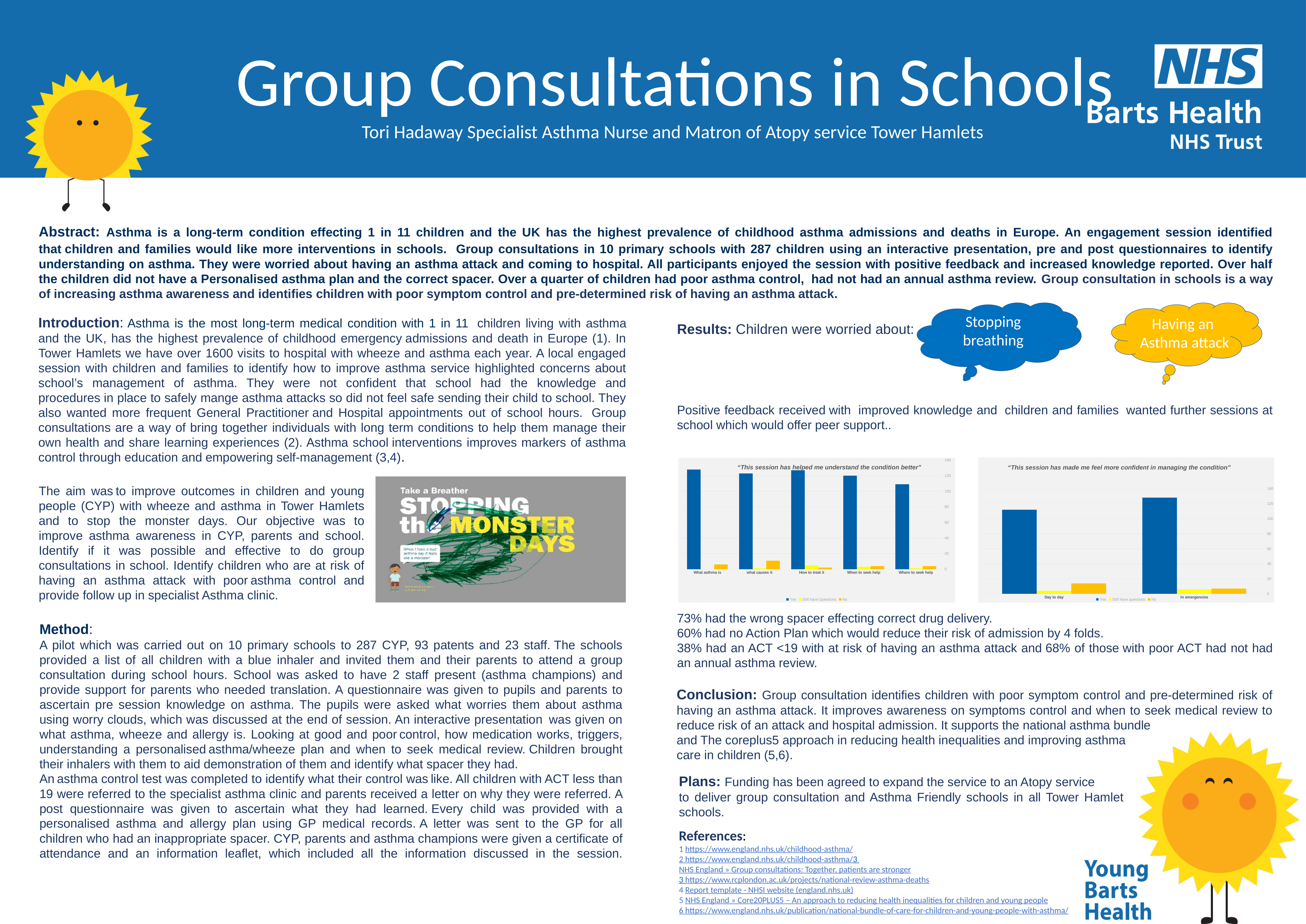
In the chart "This session has helped me understand the condition better", is the Yes value for "What asthma is" greater or less than 100? greater How many categories are shown on the x axis of the chart "This session has made me feel more confident in managing the condition"? 2 What are the legend entries in the chart "This session has made me feel more confident in managing the condition"? Yes, Still have questions, No In the chart "This session has made me feel more confident in managing the condition", which category has the higher Yes value? In emergencies What kind of chart is "This session has helped me understand the condition better"? bar chart In the chart "This session has helped me understand the condition better", which is larger: the Yes value for "What asthma is" or for "Where to seek help"? What asthma is In the chart "This session has made me feel more confident in managing the condition", is the No value for "Day to day" greater or less than 40? less In the chart "This session has made me feel more confident in managing the condition", is the Yes value for "Day to day" greater or less than 80? greater How many series does the legend list in the chart "This session has helped me understand the condition better"? 3 In the chart "This session has helped me understand the condition better", which category has the lowest Yes value? Where to seek help How many categories are shown on the x axis of the chart "This session has helped me understand the condition better"? 5